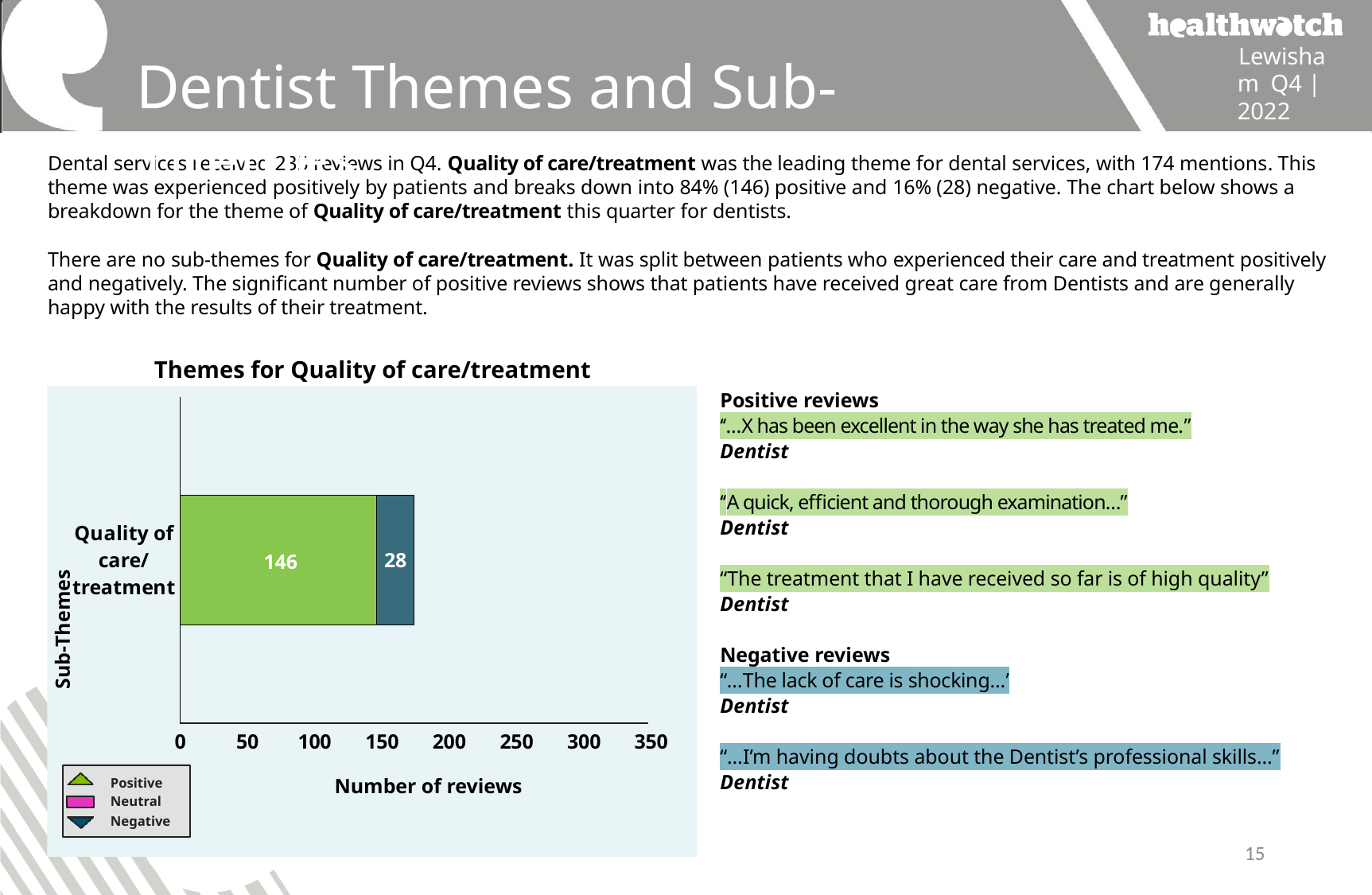
How many sub-theme categories are plotted in the chart? 1 What is the label of the x axis of the chart? Number of reviews What is the number of negative reviews for Quality of care/treatment in the chart? 28 What is the difference between the positive and negative review counts for Quality of care/treatment? 118 Is the positive review count for Quality of care/treatment greater or less than 100? greater What is the title of the chart? Themes for Quality of care/treatment Is the negative review count for Quality of care/treatment greater or less than 50? less What kind of chart is shown on the slide? Bar chart What is the total number of reviews shown in the stacked bar for Quality of care/treatment? 174 Which is larger for Quality of care/treatment: the positive or the negative review count? Positive How many series does the chart legend list? 3 What is the number of positive reviews for Quality of care/treatment in the chart? 146